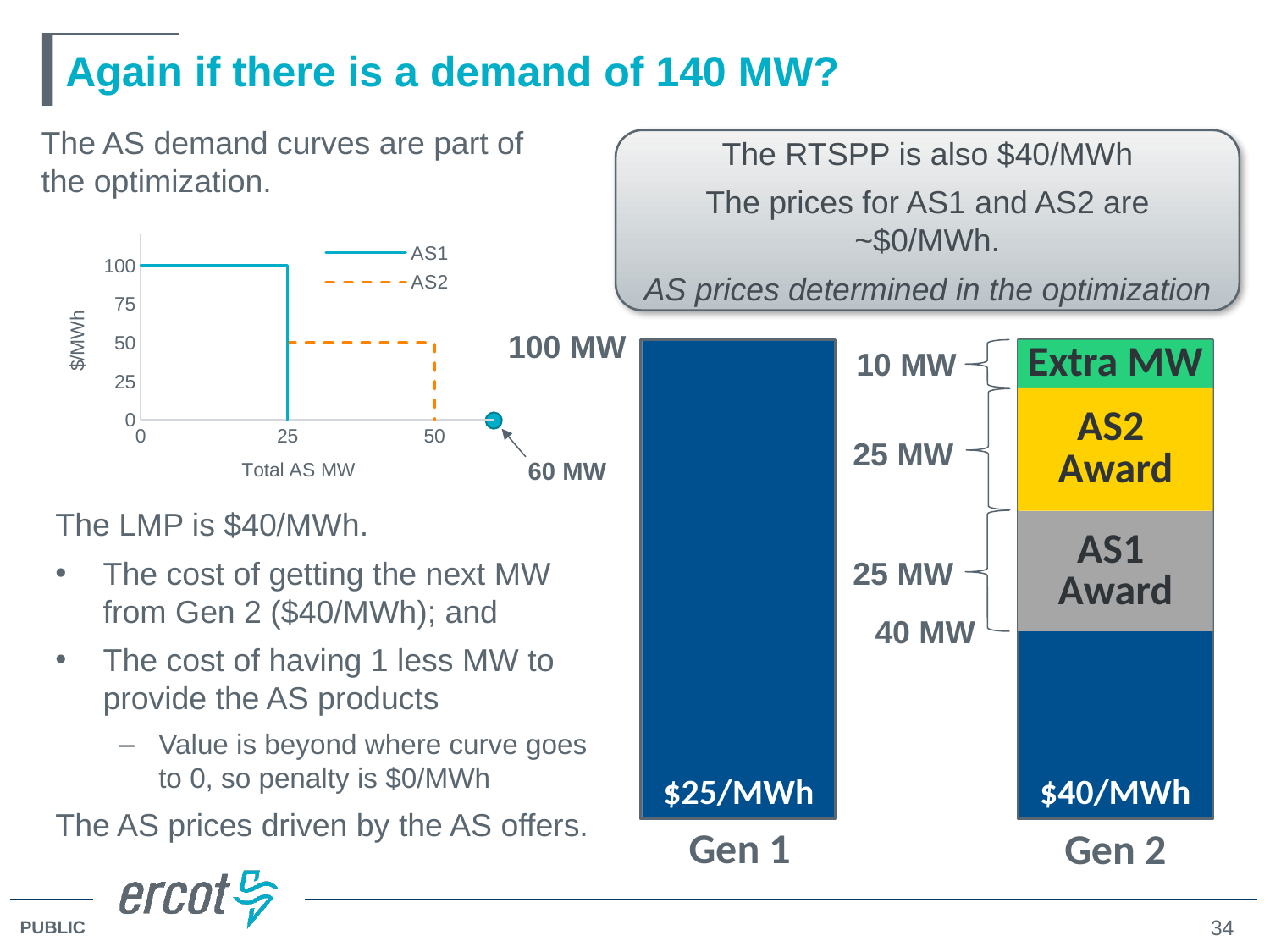
What are the two series named in the legend of the AS demand curve chart? AS1 and AS2 In the AS demand curve chart, which series has the higher price level before it drops to 0, AS1 or AS2? AS1 In the AS demand curve chart, at what Total AS MW value does the AS2 curve drop to 0? 50 In the AS demand curve chart, what is the AS1 price ($/MWh) for Total AS MW between 0 and 25? 100 In the AS demand curve chart, what is the AS2 price ($/MWh) for Total AS MW between 25 and 50? 50 What is the label of the x axis of the AS demand curve chart? Total AS MW What kind of chart is the AS demand curve chart on the left of the slide? line chart In the stacked bar diagram on the right, how many MW is the Extra MW segment of Gen 2? 10 MW In the AS demand curve chart, at what Total AS MW value does the AS1 curve drop to 0? 25 In the AS demand curve chart, is the AS2 price level between 25 and 50 MW greater or less than 75 $/MWh? less How many series does the legend of the AS demand curve chart list? 2 In the stacked bar diagram on the right, what is the total MW of the Gen 2 bar (40 MW + 25 MW + 25 MW + 10 MW)? 100 MW